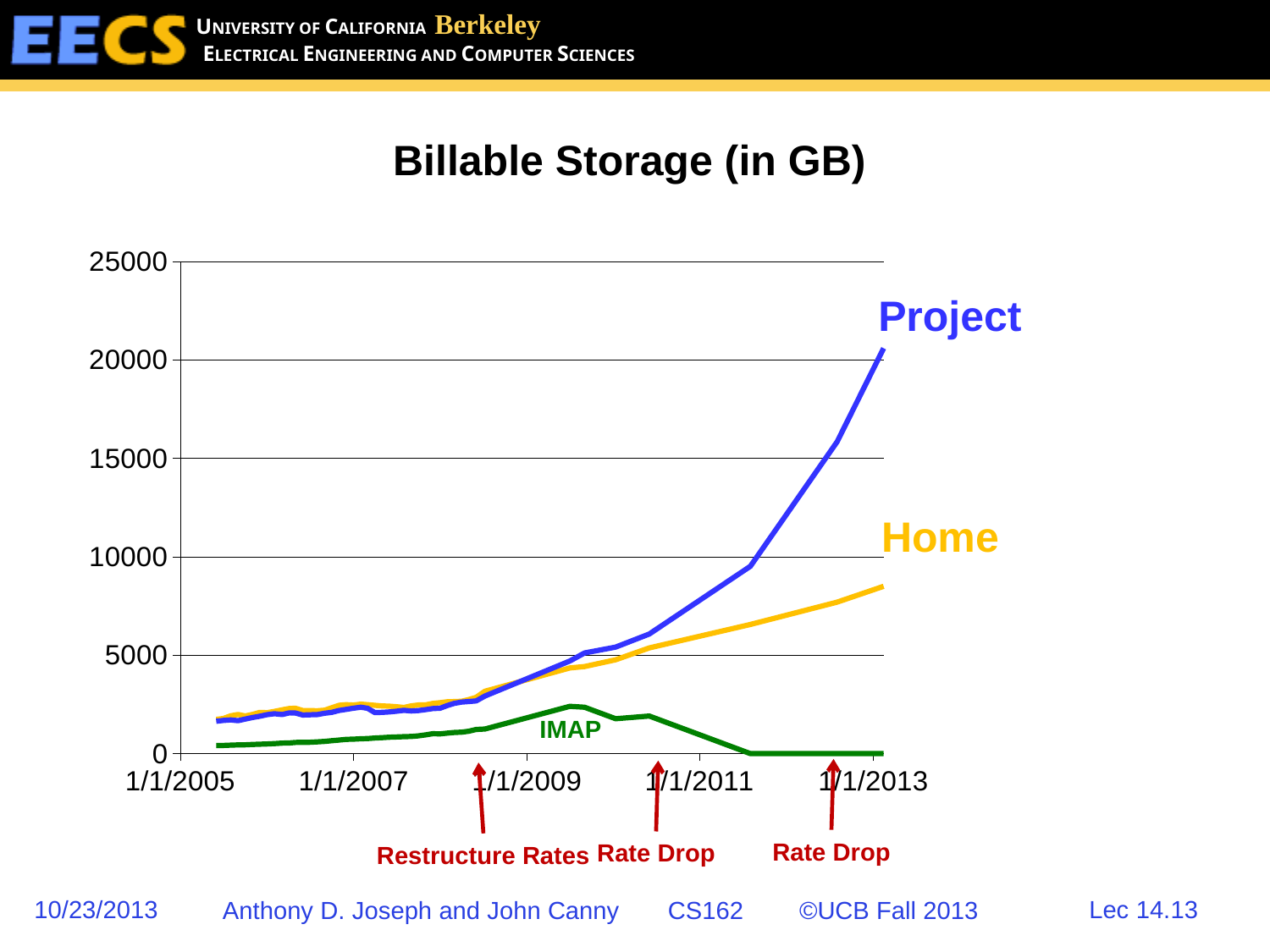
Is the value for Home at 1/1/2013 greater or less than 10000? less Which series has the highest value at 1/1/2013? Project Is the value for Home at 1/1/2009 greater or less than 5000? less What is the title of the chart? Billable Storage (in GB) Does the Project series rise or fall from 1/1/2009 to 1/1/2013? rise How many data series are plotted on the chart? 3 What kind of chart is shown on the slide? line chart At 1/1/2013, which is larger: Project or Home? Project What colour is the Project line? blue Which series has the lowest value at 1/1/2013? IMAP Is the value for Project at 1/1/2007 greater or less than 5000? less